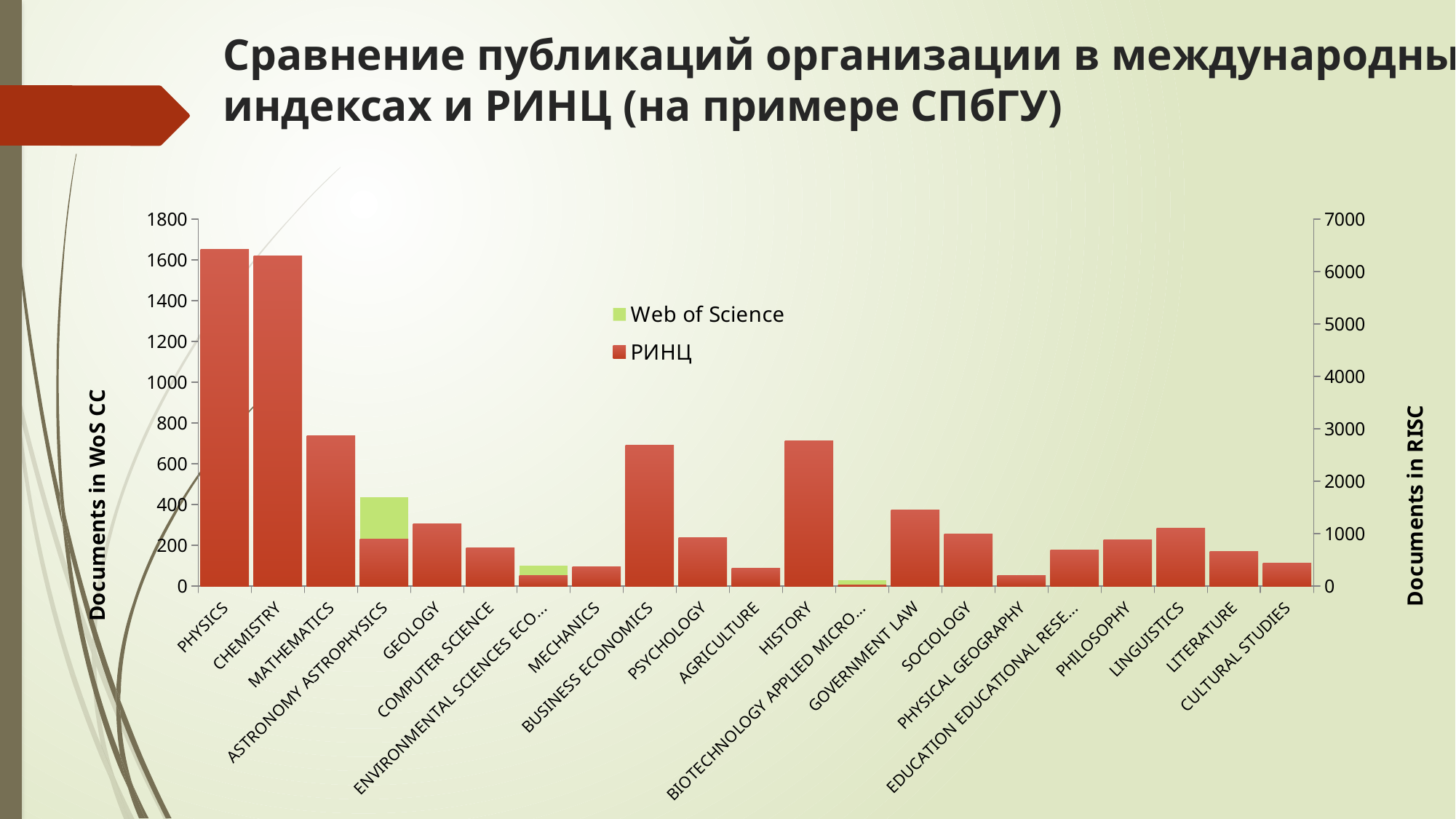
How many subject categories are shown along the x axis of the chart? 21 Which category has the shortest РИНЦ bar? BIOTECHNOLOGY APPLIED MICRO... Read against the left axis, is the Web of Science bar for ASTRONOMY ASTROPHYSICS greater or less than 200? greater What is the title of the left vertical axis of the chart? Documents in WoS CC Read against the left axis, is the РИНЦ bar for AGRICULTURE greater or less than 200? less Which has the taller РИНЦ bar, GOVERNMENT LAW or PHYSICAL GEOGRAPHY? GOVERNMENT LAW Which has the taller РИНЦ bar, MATHEMATICS or GEOLOGY? MATHEMATICS Which two series are listed in the chart legend? Web of Science and РИНЦ How many series does the chart legend list? 2 Which has the taller РИНЦ bar, LINGUISTICS or CULTURAL STUDIES? LINGUISTICS What kind of chart is shown on the slide? bar chart